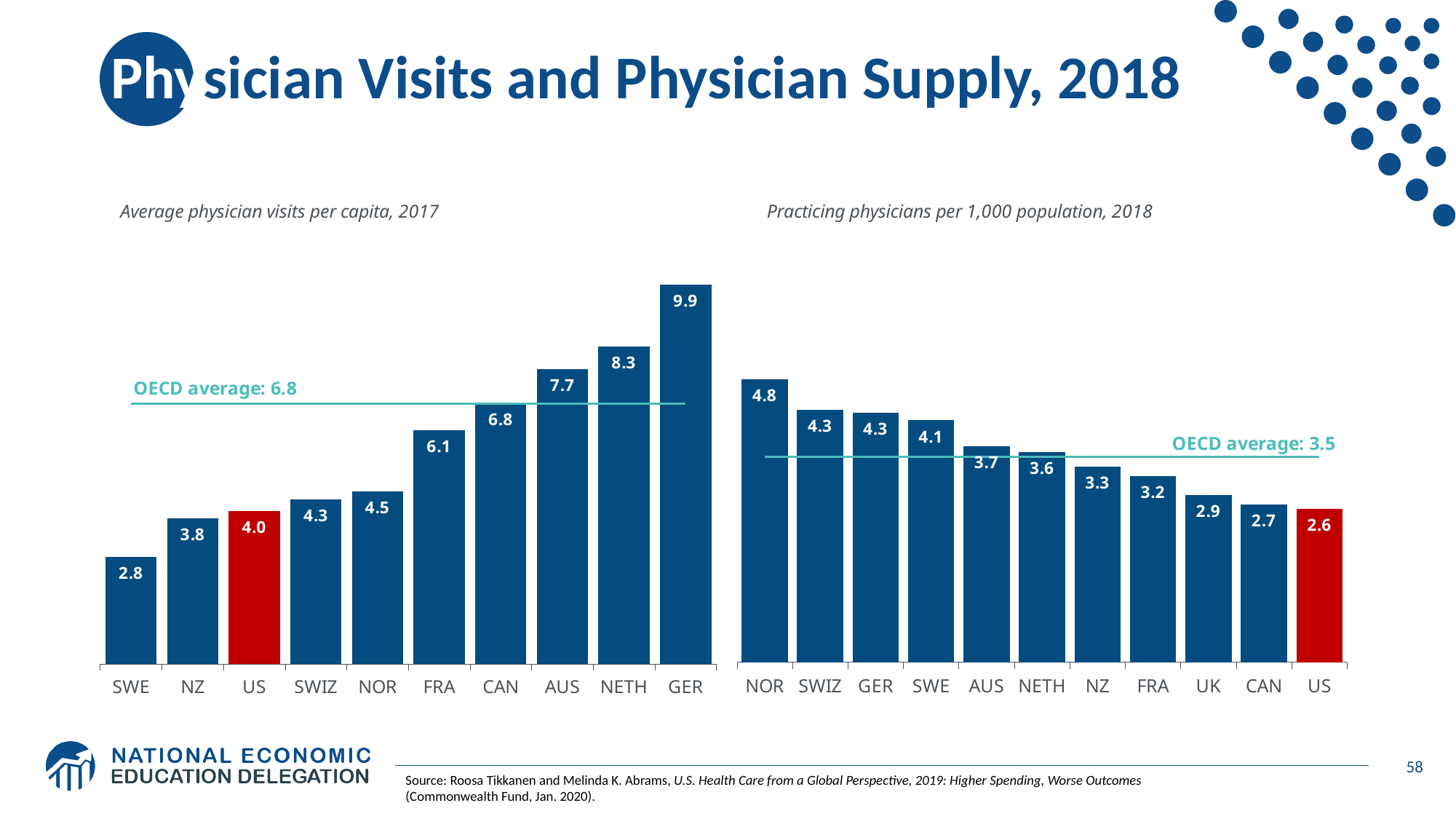
In the 'Average physician visits per capita, 2017' chart, what is the value for GER? 9.9 How many countries are shown in the 'Average physician visits per capita, 2017' chart? 10 In the 'Average physician visits per capita, 2017' chart, what is the value for the US? 4.0 What is the OECD average shown in the 'Practicing physicians per 1,000 population, 2018' chart? 3.5 In the 'Practicing physicians per 1,000 population, 2018' chart, which is larger, the value for SWE or the value for FRA? SWE In the 'Practicing physicians per 1,000 population, 2018' chart, what is the value for NOR? 4.8 In the 'Practicing physicians per 1,000 population, 2018' chart, which country has the lowest value? US In the 'Average physician visits per capita, 2017' chart, what is the difference between GER and SWE? 7.1 How many countries are shown in the 'Practicing physicians per 1,000 population, 2018' chart? 11 In the 'Average physician visits per capita, 2017' chart, which country has the lowest value? SWE In the 'Average physician visits per capita, 2017' chart, which country has the highest value? GER In the 'Practicing physicians per 1,000 population, 2018' chart, what is the difference between NOR and the US? 2.2